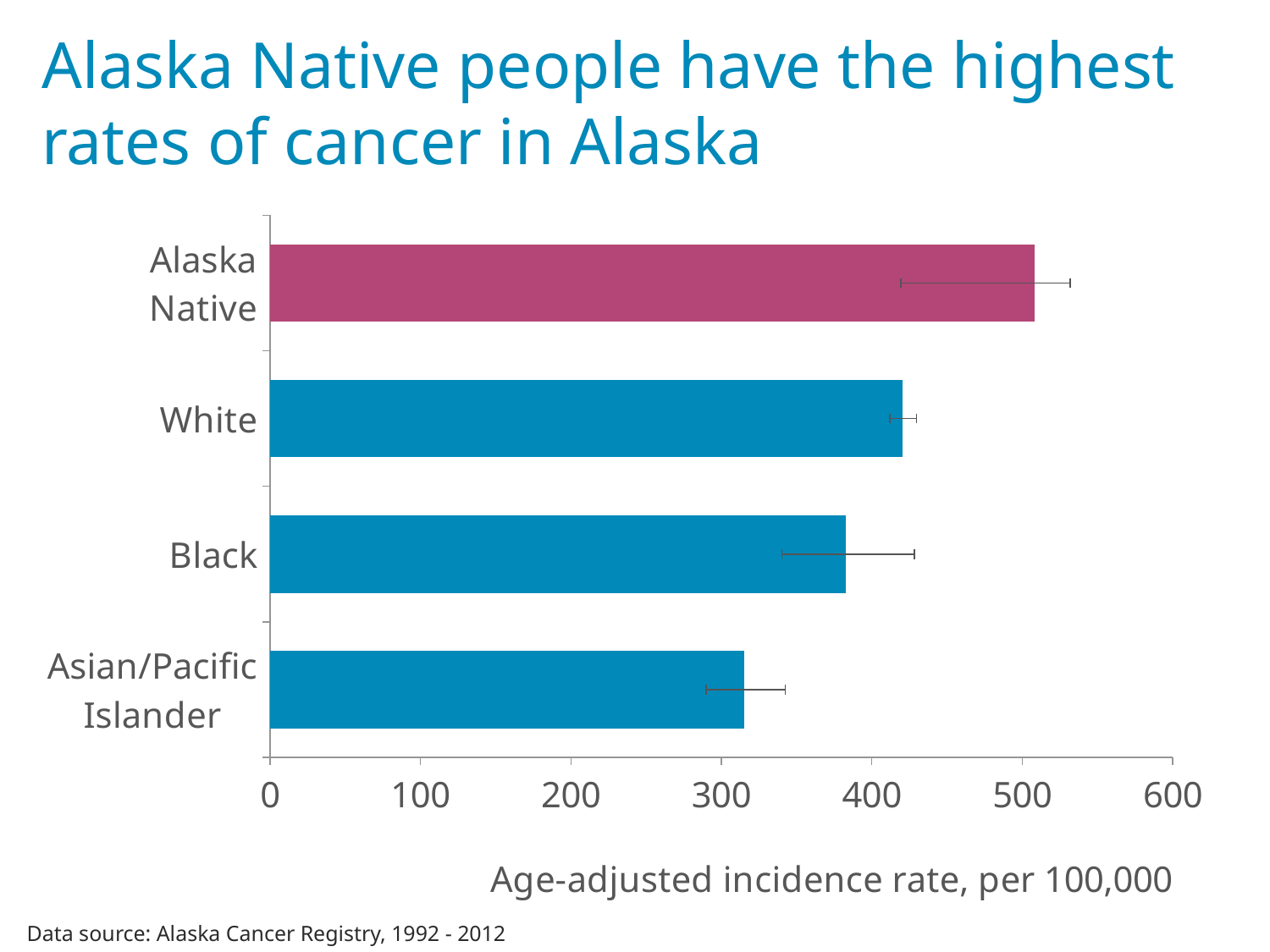
How many categories are plotted in the chart? 4 Is the value for Black greater or less than 400? less Which has a higher incidence rate, White or Black? White Is the value for Asian/Pacific Islander greater or less than 400? less Which category's bar is coloured differently (magenta) from the others? Alaska Native What is the label of the horizontal axis? Age-adjusted incidence rate, per 100,000 Is the value for Asian/Pacific Islander greater or less than 300? greater Which category has the lowest age-adjusted incidence rate? Asian/Pacific Islander Which category has the highest age-adjusted incidence rate? Alaska Native What kind of chart is shown on the slide? bar chart